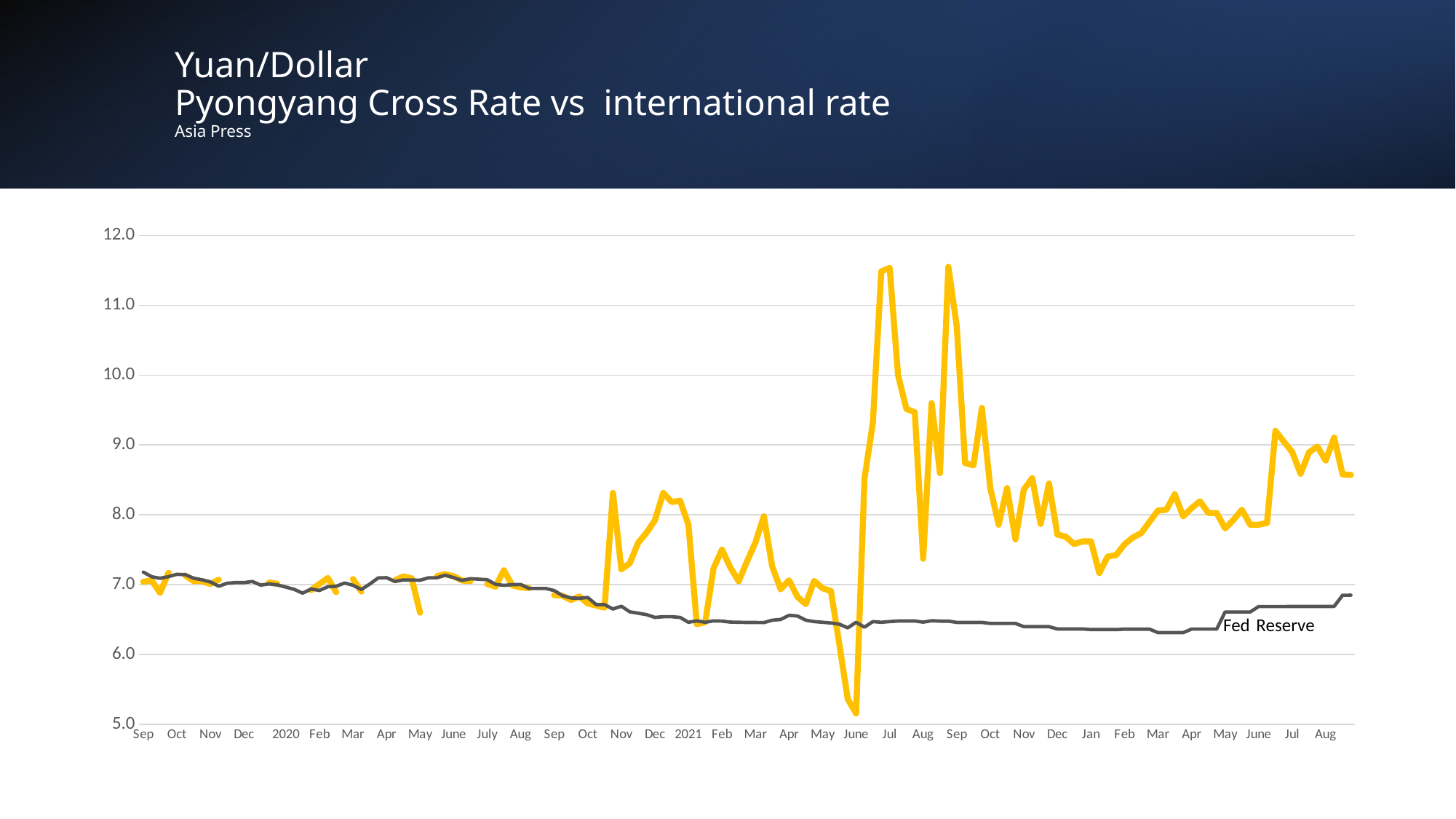
What kind of chart is shown on the slide? Line chart Is the value of the Fed Reserve line at the end of the series (Aug 2022) greater or less than 7.0? less Does the Fed Reserve line rise or fall overall from Sep 2019 to Mar 2022? Fall At Aug 2022, which line is higher, the yellow line or the Fed Reserve line? The yellow line What is the highest value shown on the vertical axis? 12.0 Is the peak value of the yellow line around Jul 2021 greater or less than 11.0? greater Is the lowest value of the yellow line around June 2021 greater or less than 6.0? less How many lines are plotted on the chart? 2 Which line on the chart is labelled directly on the plot? Fed Reserve What is the title of the chart on the slide? Yuan/Dollar Pyongyang Cross Rate vs international rate